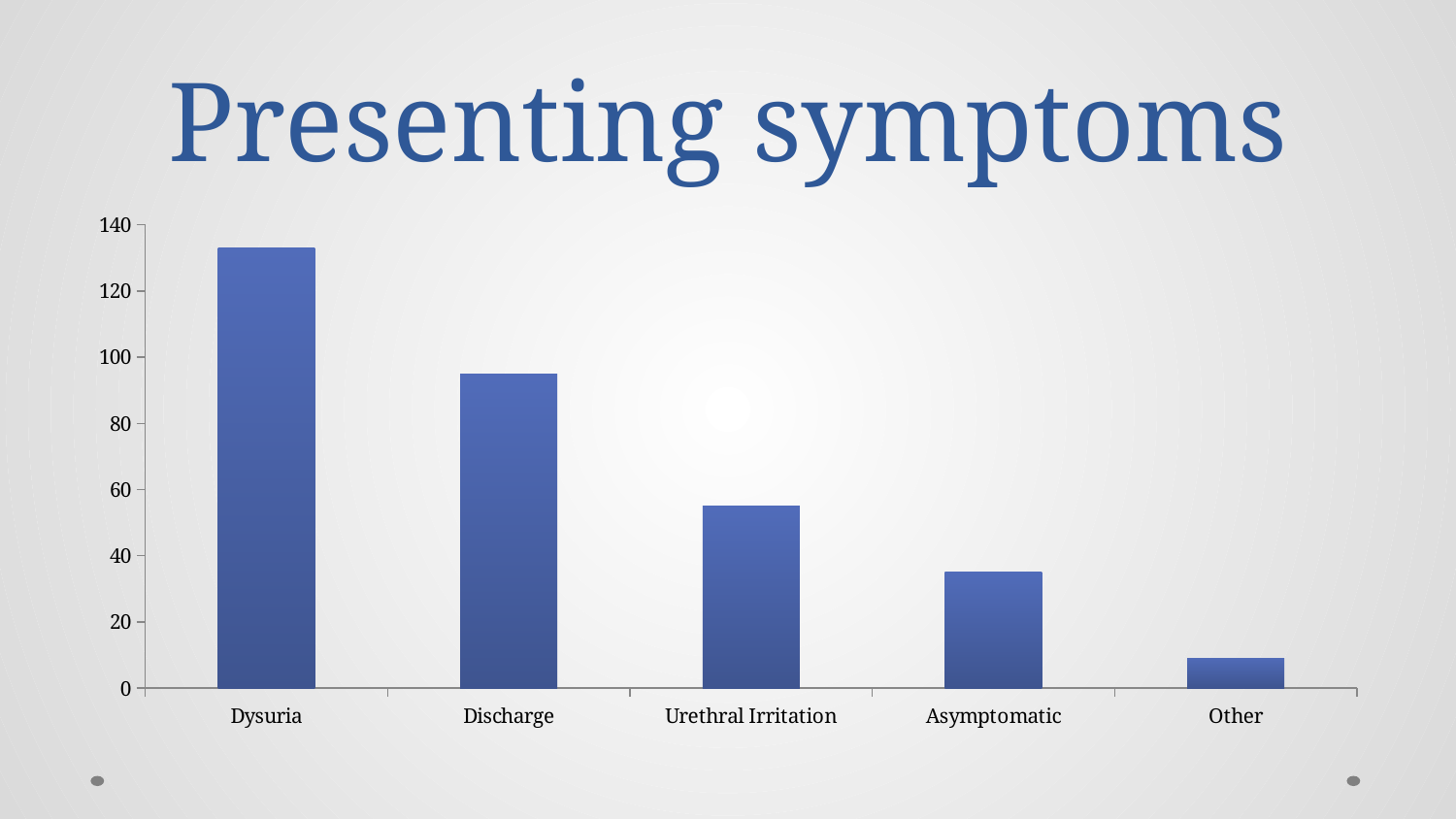
Is the value for Dysuria greater or less than 120? greater What is the title of the chart? Presenting symptoms Do the values rise or fall moving from left to right along the x axis? fall Is the value for Urethral Irritation greater or less than 40? greater Is the value for Discharge greater or less than 100? less What kind of chart is shown on the slide? bar chart Which presenting symptom has the highest value? Dysuria How many symptom categories are shown on the x axis? 5 Which presenting symptom has the lowest value? Other Which is larger, the value for Discharge or the value for Urethral Irritation? Discharge